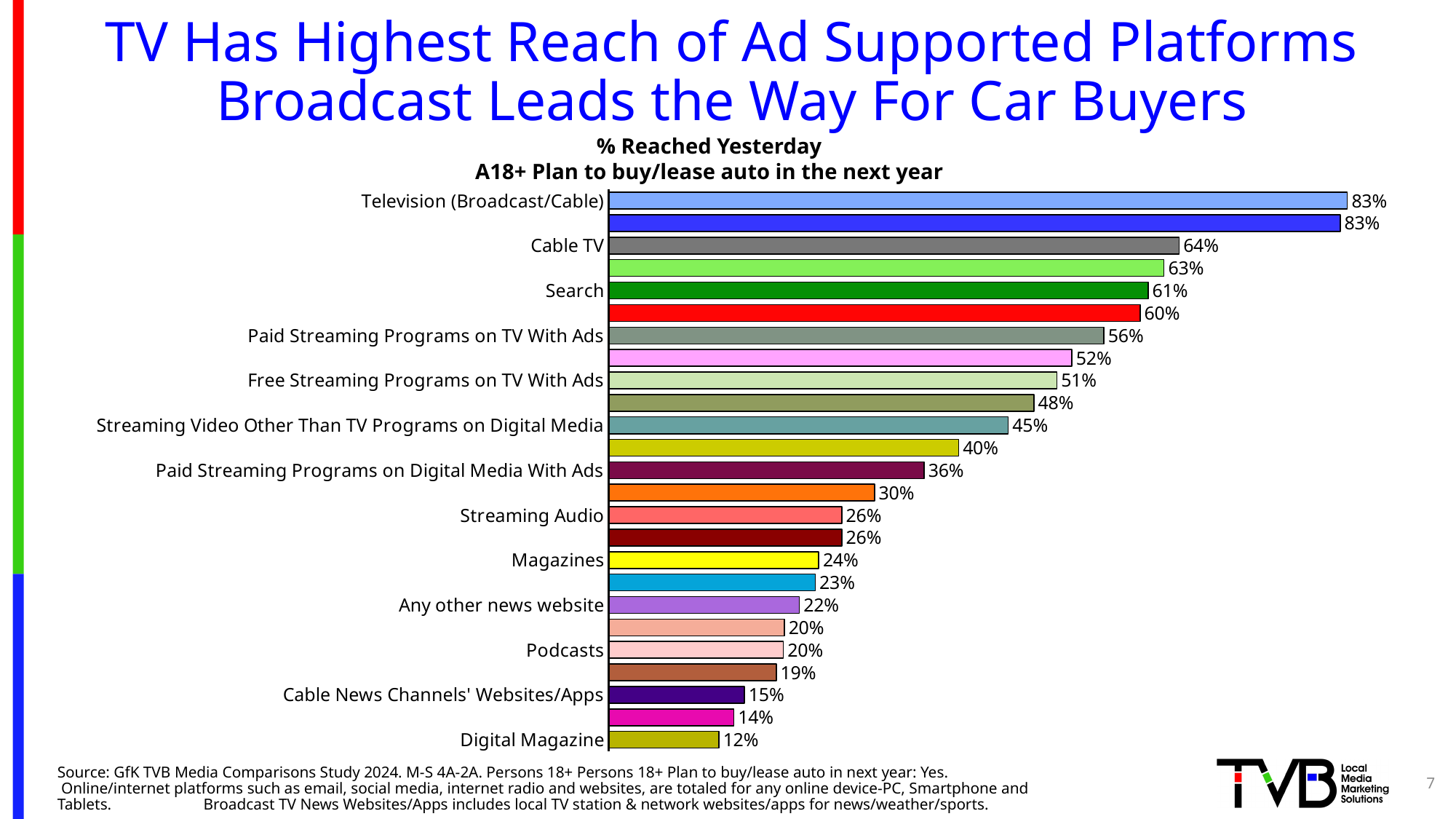
How many bars are plotted on the chart? 25 Which is larger, the value for Free Streaming Programs on TV With Ads or the value for Streaming Audio? Free Streaming Programs on TV With Ads Which category has the lowest value? Digital Magazine What is the value for Search? 61% What is the highest value shown on the chart? 83% What is the value for Podcasts? 20% What is the difference between the values for Cable TV and Magazines? 40% What is the value for Cable TV? 64% What is the value for Paid Streaming Programs on TV With Ads? 56% What is the chart's title? % Reached Yesterday A18+ Plan to buy/lease auto in the next year What is the value for Streaming Video Other Than TV Programs on Digital Media? 45% What kind of chart is shown on the slide? Bar chart